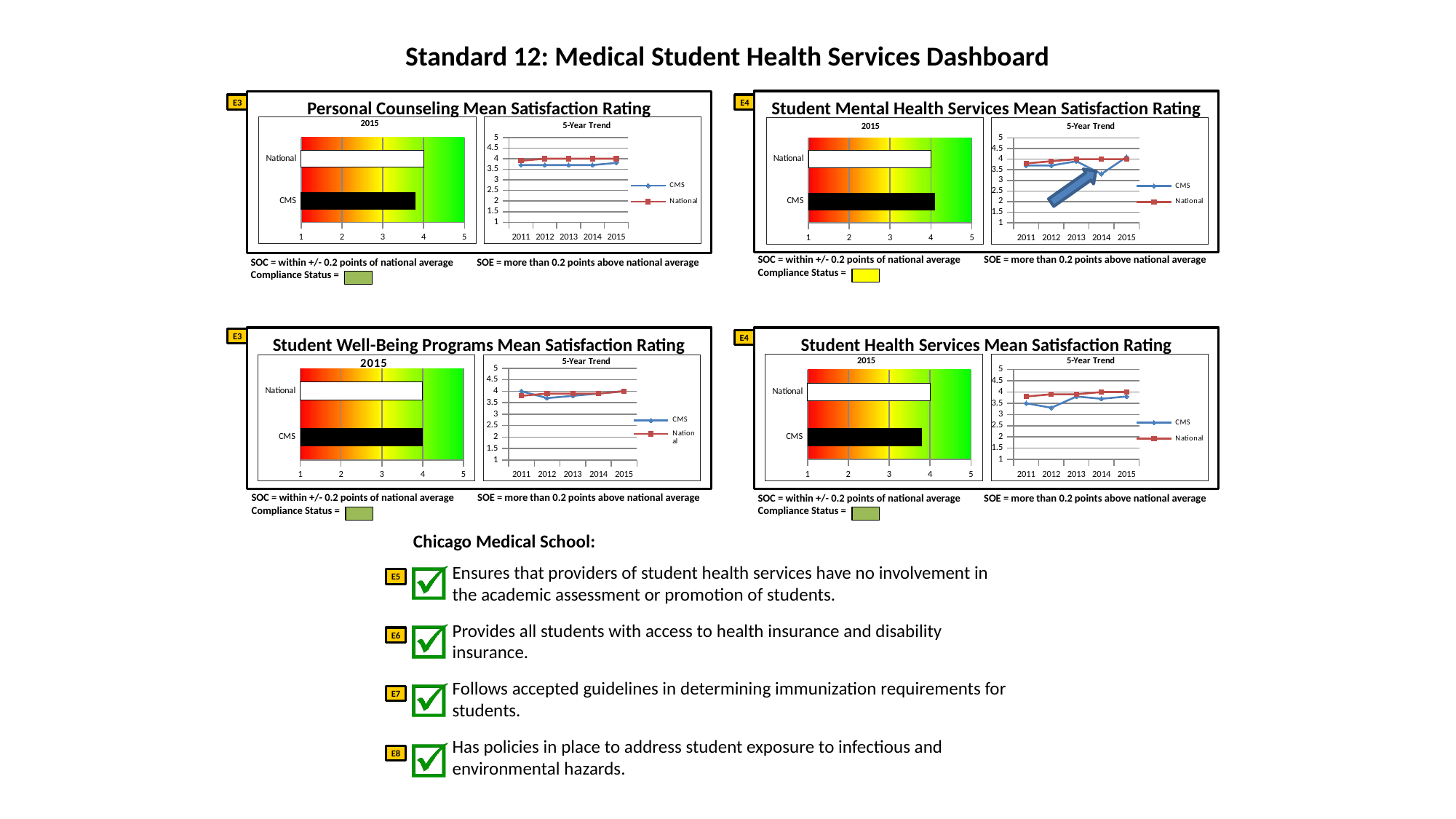
How many years are plotted on the x axis of the Personal Counseling Mean Satisfaction Rating 5-Year Trend chart? 5 In the Student Health Services Mean Satisfaction Rating 2015 chart, which is larger, the National bar or the CMS bar? National In the Personal Counseling Mean Satisfaction Rating panel, what kind of chart is the 2015 chart? bar chart In the Student Health Services Mean Satisfaction Rating 2015 chart, is the value for CMS greater or less than 4? less In the Student Health Services Mean Satisfaction Rating 5-Year Trend chart, in which year is the CMS value lowest? 2012 How many series does the legend of the Student Well-Being Programs 5-Year Trend chart list? 2 How many categories are shown in the Student Health Services Mean Satisfaction Rating 2015 bar chart? 2 In the Personal Counseling Mean Satisfaction Rating 2015 chart, is the value for CMS greater or less than 3? greater In the Personal Counseling Mean Satisfaction Rating panel, what kind of chart is the 5-Year Trend chart? line chart In the Student Mental Health Services Mean Satisfaction Rating 5-Year Trend chart, is the CMS value for 2014 greater or less than 3.5? less In the Student Health Services Mean Satisfaction Rating 5-Year Trend chart, does the CMS line rise or fall from 2012 to 2015? rise In the Student Mental Health Services Mean Satisfaction Rating 5-Year Trend chart, which is larger, the CMS value for 2014 or for 2015? 2015